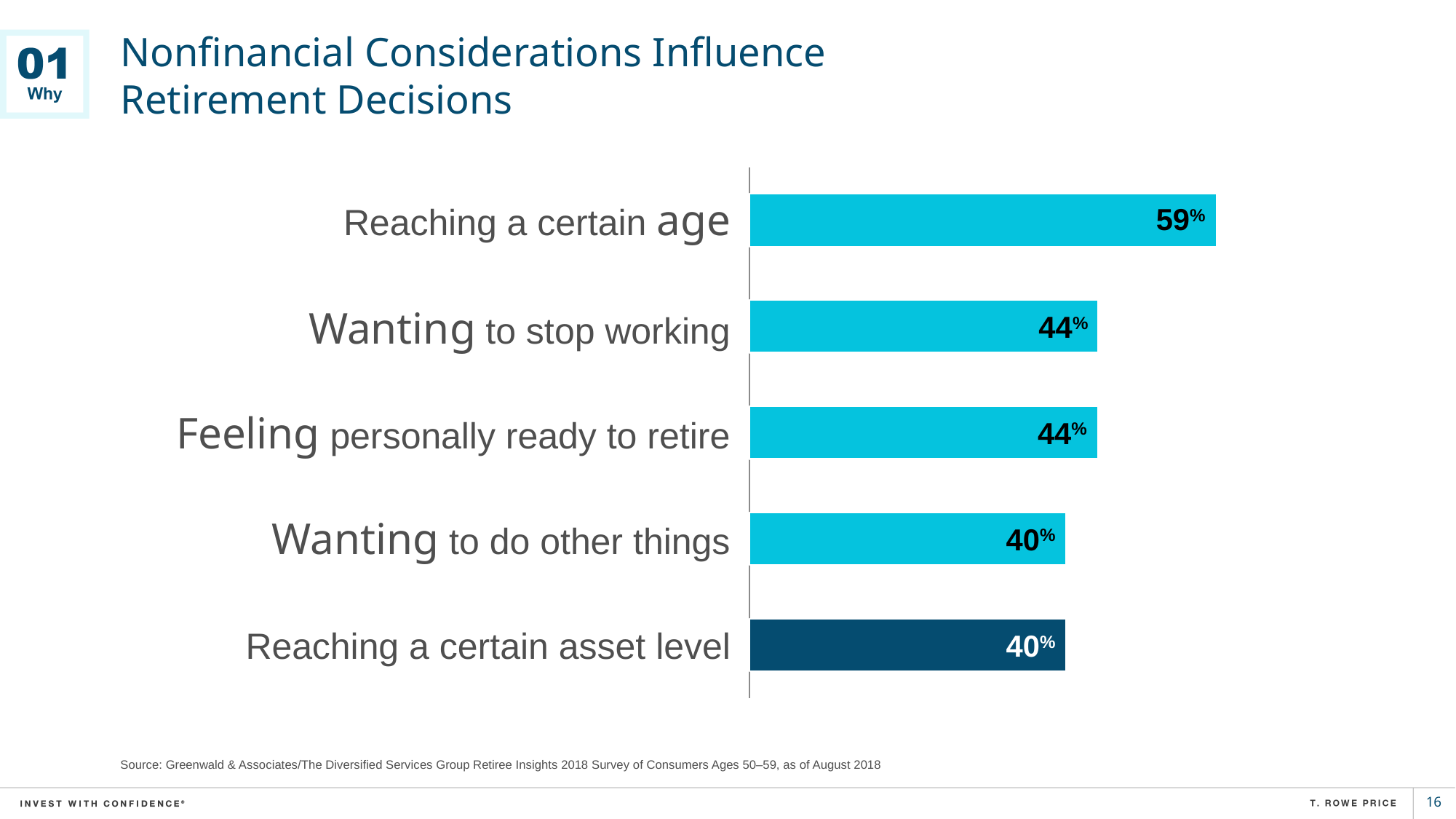
What kind of chart is shown on the slide? Bar chart What is the difference between the values for "Reaching a certain age" and "Wanting to stop working"? 15% What is the value for "Wanting to do other things"? 40% Which bar is shown in a darker colour than the others? Reaching a certain asset level How many categories are shown in the chart? 5 What is the value for "Wanting to stop working"? 44% Which is larger, the value for "Reaching a certain age" or the value for "Reaching a certain asset level"? Reaching a certain age How many categories share the value 44%? 2 What is the value for "Reaching a certain age"? 59% What is the value for "Reaching a certain asset level"? 40% Which category has the highest value? Reaching a certain age What is the difference between the values for "Feeling personally ready to retire" and "Wanting to do other things"? 4%